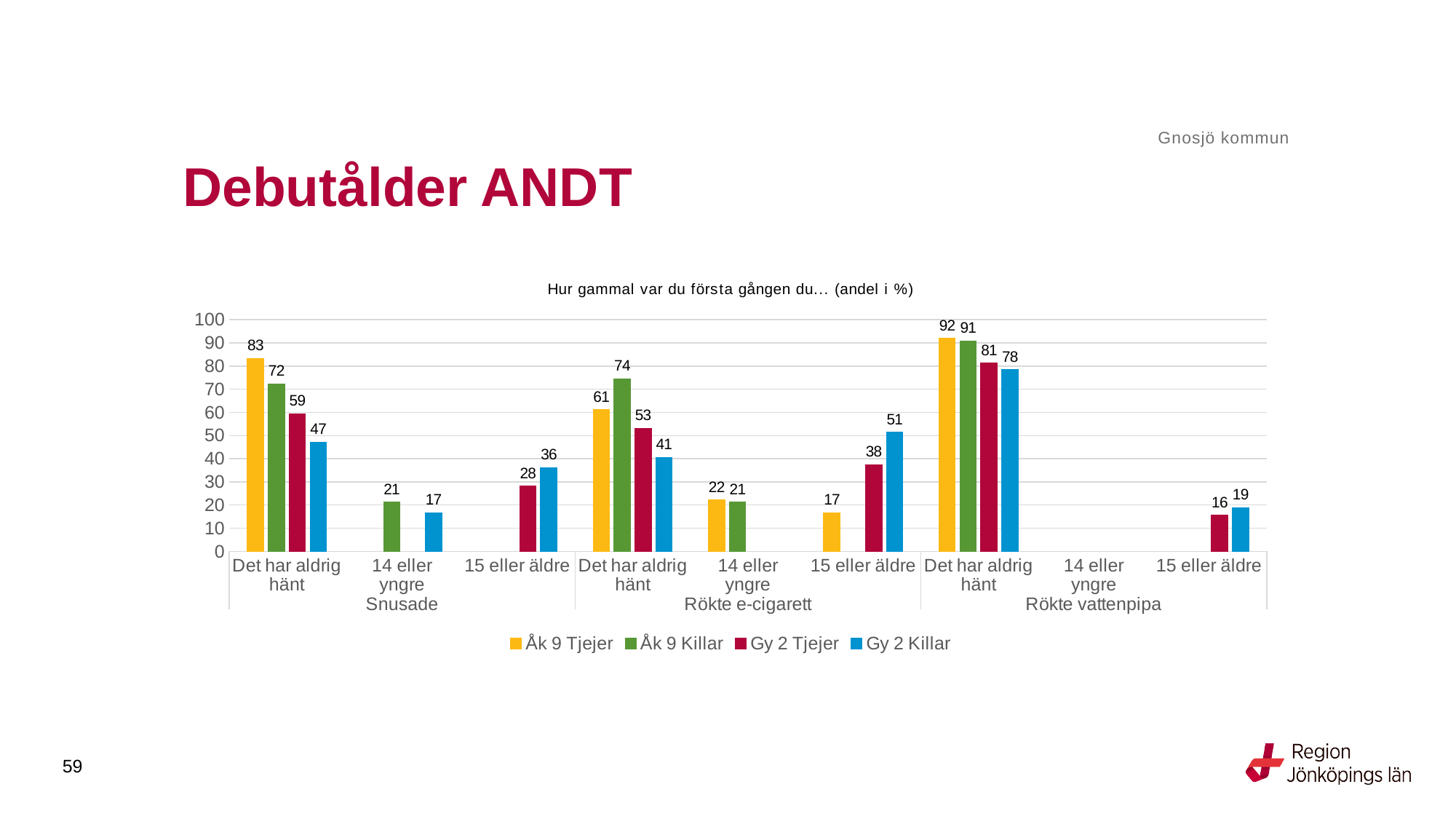
What is the title of the chart? Hur gammal var du första gången du… (andel i %) Which series has the highest value for 'Det har aldrig hänt' under Rökte e-cigarett? Åk 9 Killar What is the value for Gy 2 Tjejer for 'Det har aldrig hänt' under Rökte vattenpipa? 81 How many series does the legend list? 4 What is the value for Gy 2 Tjejer for '15 eller äldre' under Rökte vattenpipa? 16 Which is larger for '15 eller äldre' under Snusade: Gy 2 Tjejer or Gy 2 Killar? Gy 2 Killar What is the value for Gy 2 Killar for '15 eller äldre' under Rökte e-cigarett? 51 What kind of chart is shown on the slide? Bar chart What is the difference between Åk 9 Tjejer and Gy 2 Killar for 'Det har aldrig hänt' under Snusade? 36 Which series has the lowest value for 'Det har aldrig hänt' under Snusade? Gy 2 Killar Is the value for Gy 2 Killar for 'Det har aldrig hänt' under Rökte vattenpipa greater or less than 70? greater What is the value for Åk 9 Tjejer for 'Det har aldrig hänt' under Snusade? 83